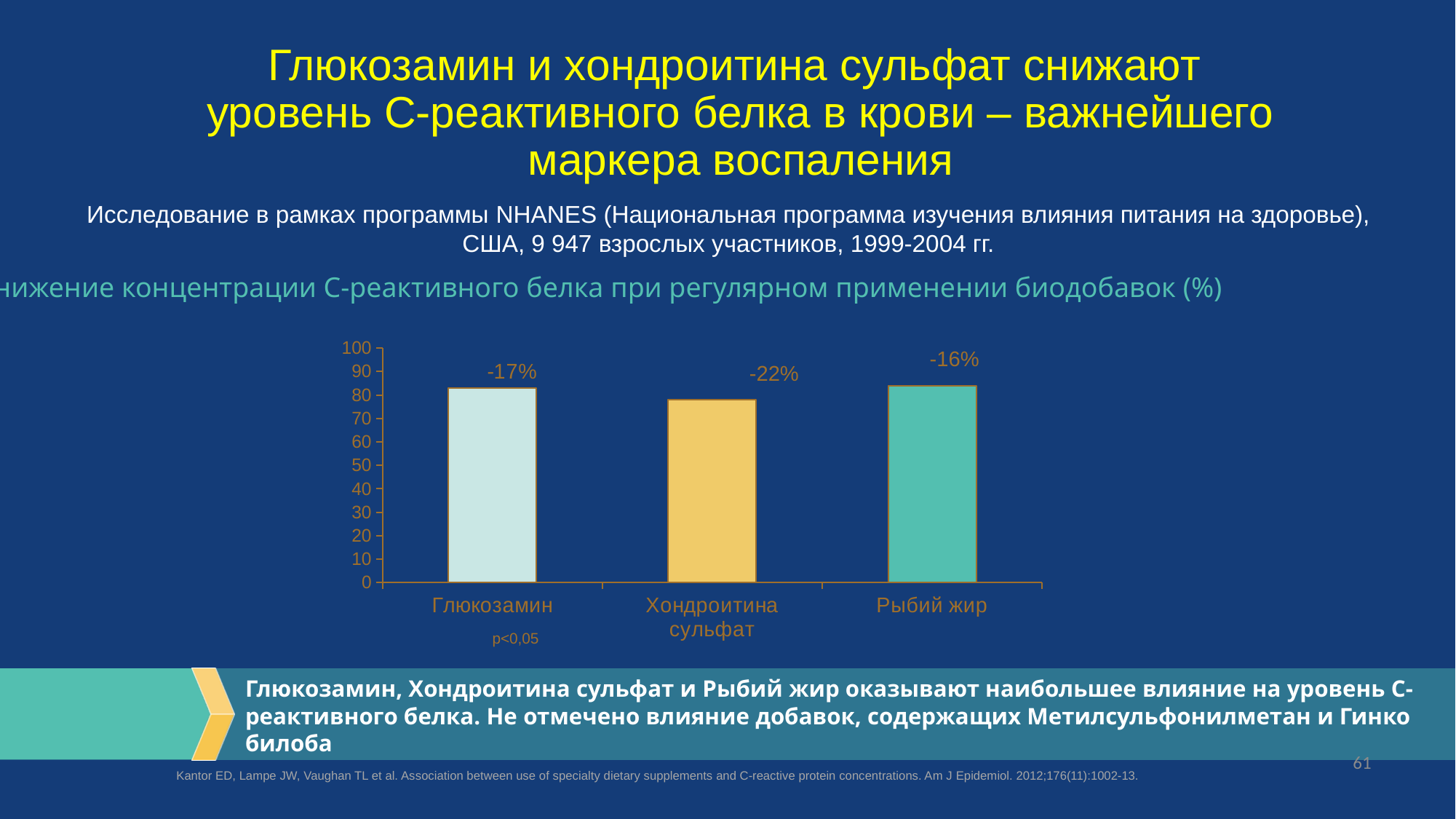
Which bar is taller: Глюкозамин or Хондроитина сульфат? Глюкозамин Is the bar for Рыбий жир greater or less than 90 on the y axis? less What is the maximum value shown on the y axis? 100 What significance note is printed below the Глюкозамин category label? p<0,05 Is the bar for Хондроитина сульфат greater or less than 70 on the y axis? greater Which category has the lowest bar on the chart? Хондроитина сульфат How many categories are plotted on the chart? 3 What data label is shown above the bar for Хондроитина сульфат? -22% What data label is shown above the bar for Рыбий жир? -16% What data label is shown above the bar for Глюкозамин? -17% Which category shows the largest percentage reduction according to the data labels? Хондроитина сульфат What kind of chart is shown on the slide? Bar chart